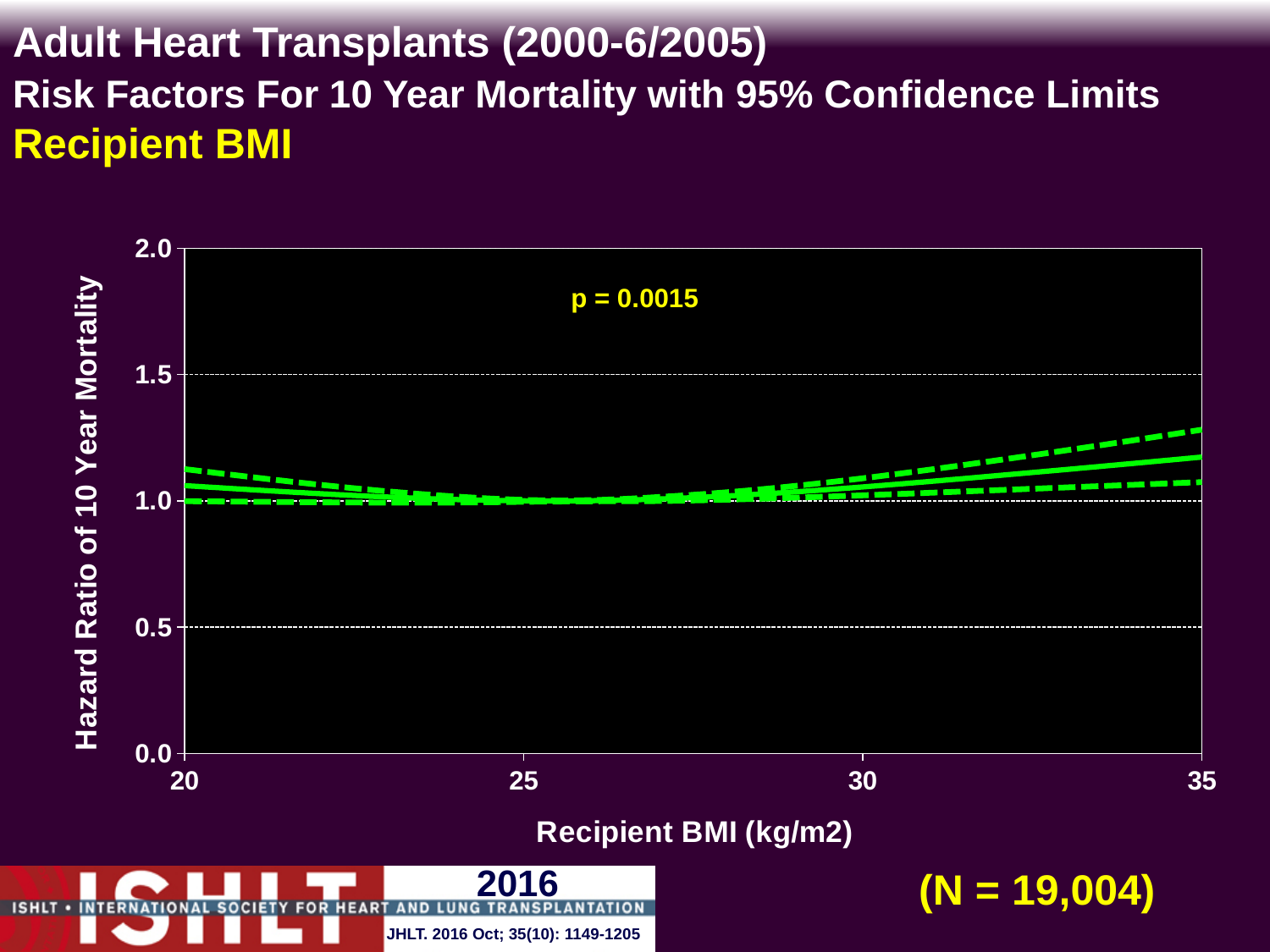
Is the hazard ratio (solid line) at a recipient BMI of 35 greater or less than 1.0? greater What kind of chart is shown on the slide? line chart Is the lower confidence limit (lower dashed line) at a recipient BMI of 20 greater or less than 1.5? less Is the upper confidence limit (upper dashed line) at a recipient BMI of 35 greater or less than 1.5? less What p-value is printed on the chart? p = 0.0015 Which recipient BMI has the higher hazard ratio on the solid line, 20 or 35? 35 What is the highest value shown on the y axis of the chart? 2.0 How many lines are plotted on the chart (the hazard ratio plus its confidence limits)? 3 Does the hazard ratio (solid line) rise or fall as recipient BMI increases from 30 to 35? rise